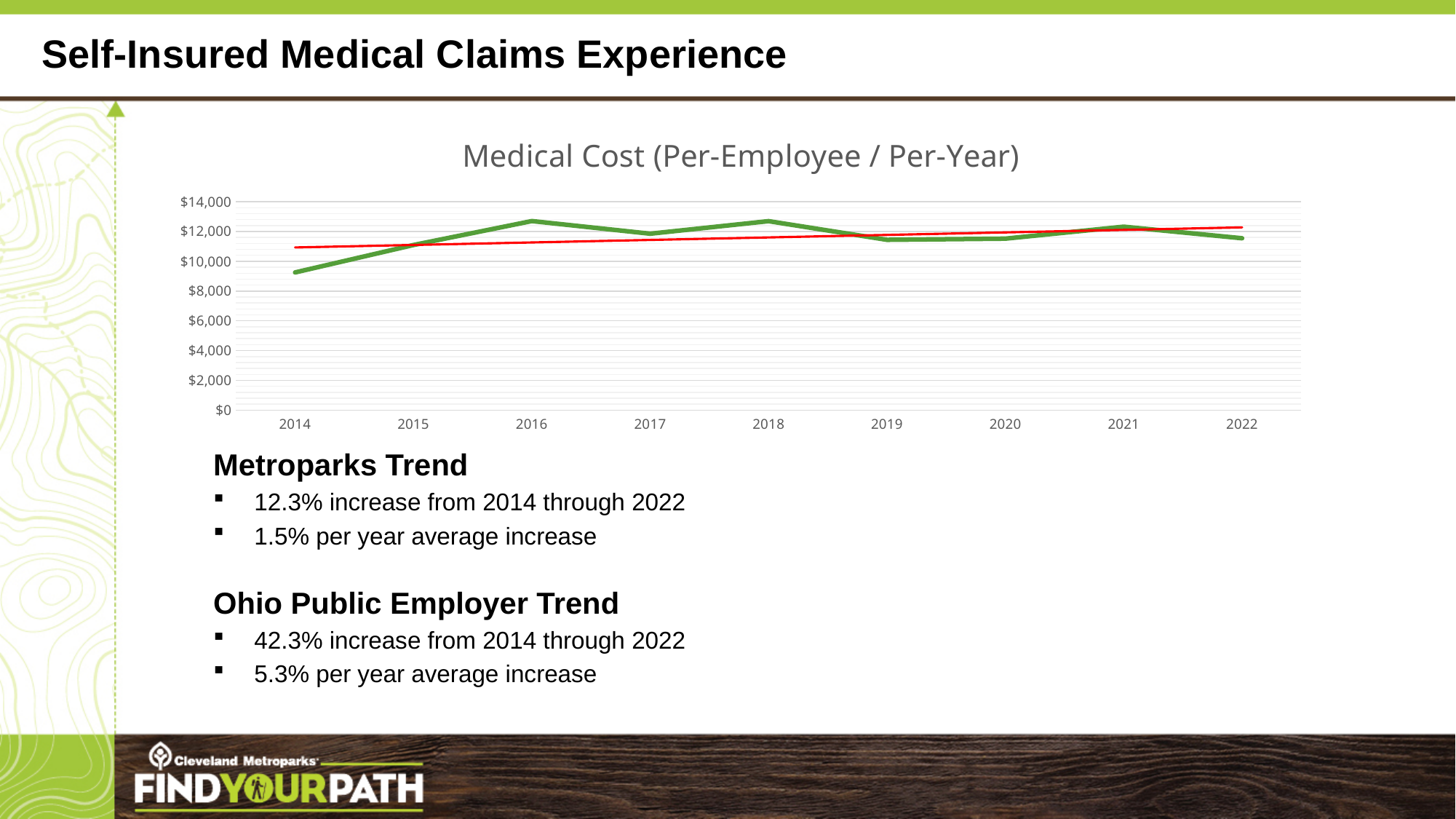
Is the value of the green line for 2014 greater or less than $10,000? less What is the first year shown on the x axis of the chart? 2014 Is the value of the green line for 2019 greater or less than $12,000? less Which year has the higher value on the green line, 2014 or 2016? 2016 Is the value of the green line for 2018 greater or less than $12,000? greater What is the title of the chart? Medical Cost (Per-Employee / Per-Year) Which year has the lowest medical cost per employee on the green line? 2014 How many years are plotted along the x axis of the chart? 9 What kind of chart is shown on the slide? line chart What is the highest value shown on the y axis of the chart? $14,000 Does the green line rise or fall between 2014 and 2016? rise